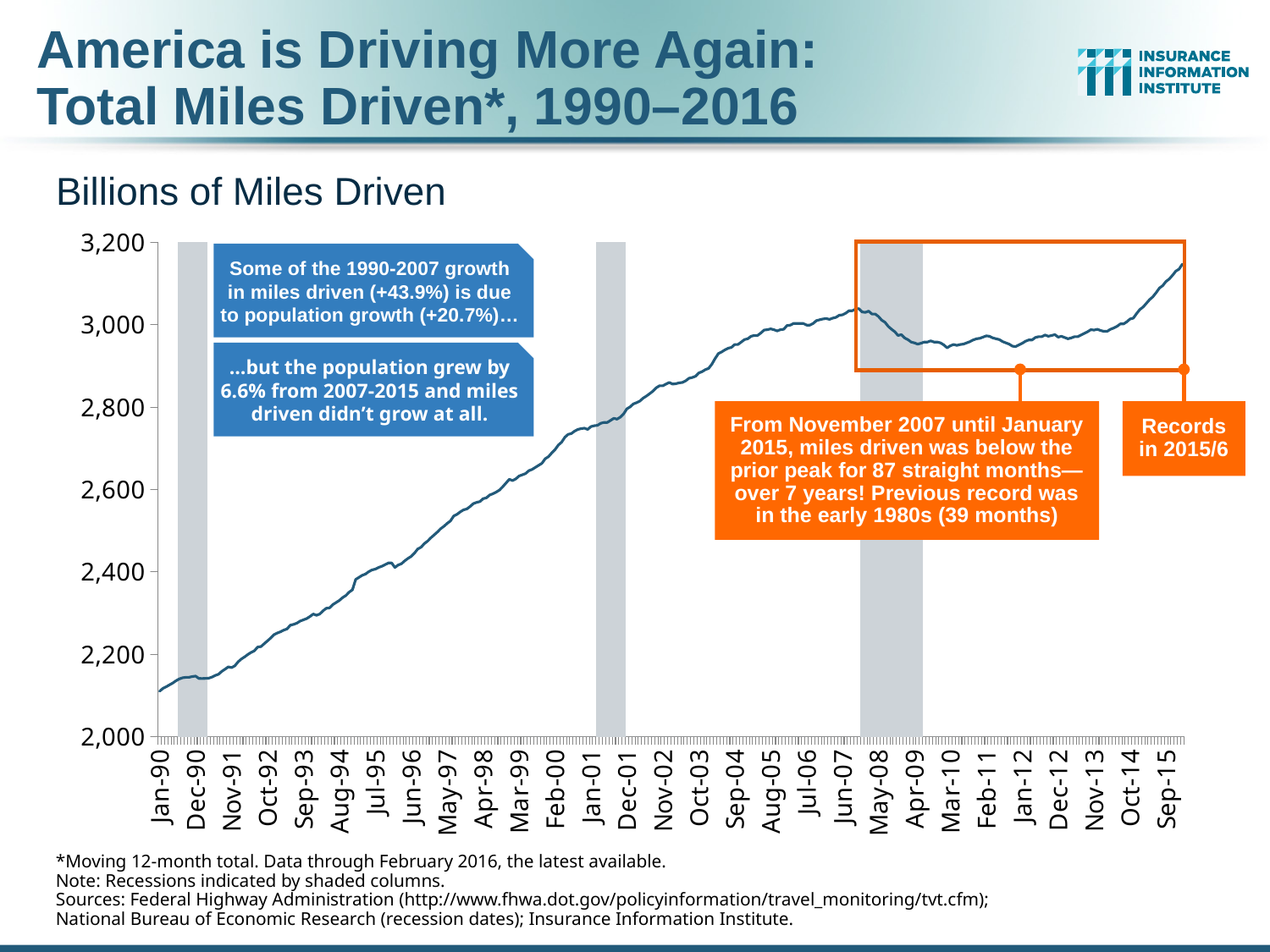
Is the value for Jan-90 greater or less than 2,200? less What type of chart is shown on the slide? line chart According to the note, what do the shaded columns on the chart indicate? Recessions At which end of the x axis, Jan-90 or Sep-15, is the line at its lowest? Jan-90 Is the value for Jun-96 greater or less than 2,200? greater Is the value for Feb-00 greater or less than 2,600? greater Do the values rise or fall from Jan-90 to Jun-07? rise Do the values rise or fall from Jun-07 to Mar-10? fall What does the label above the chart say the values are measured in? Billions of Miles Driven